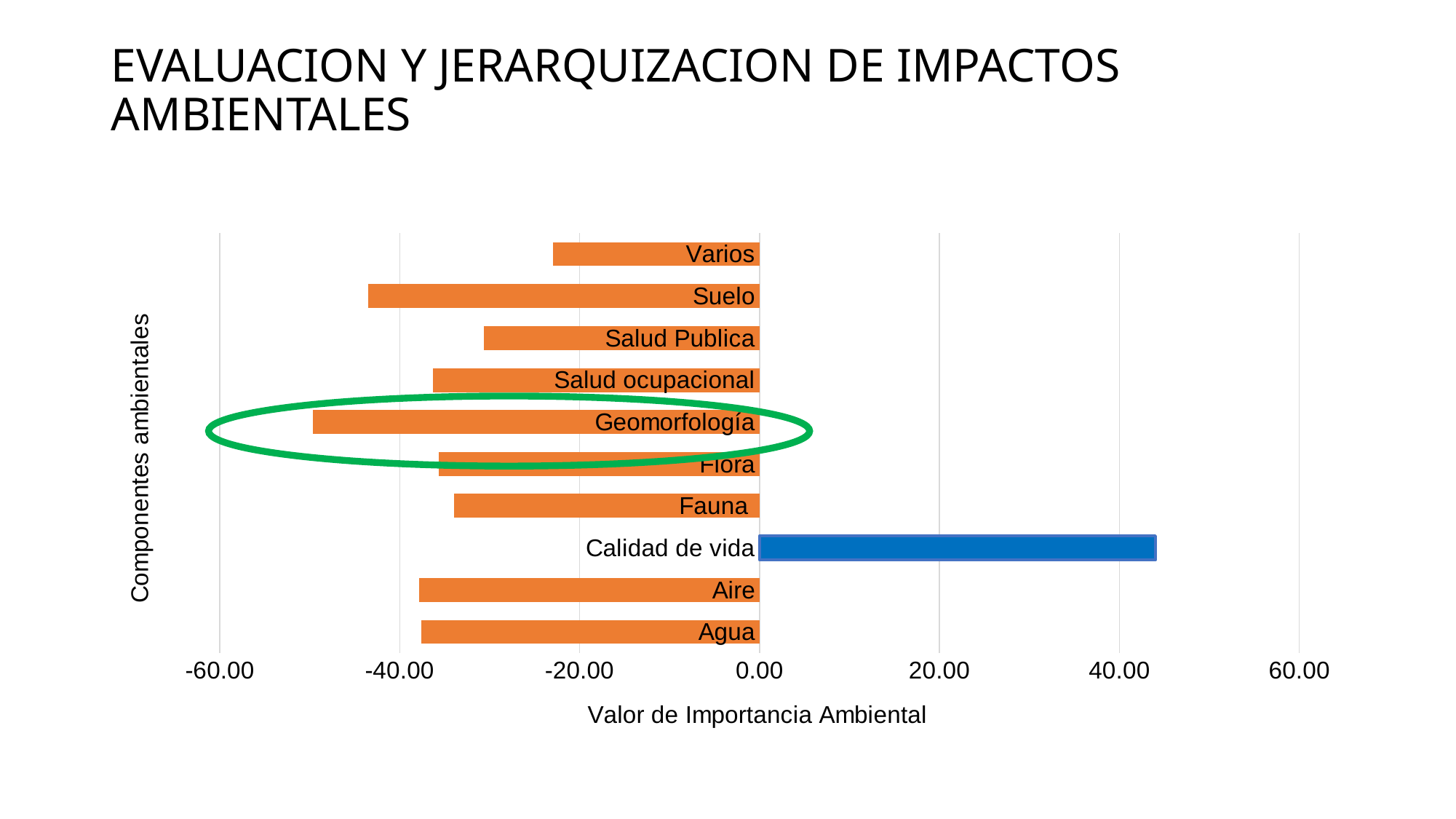
Which bar extends further from zero, Suelo or Varios? Suelo Which category has the highest value in the chart? Calidad de vida Which category has the lowest (most negative) value in the chart? Geomorfología What kind of chart is shown on the slide? bar chart Is the value for Fauna greater or less than -40.00? greater Is the value for Calidad de vida greater or less than 40.00? greater Is the value for Suelo greater or less than -40.00? less Which category is highlighted with a green ellipse on the chart? Geomorfología What is the title of the horizontal (x) axis of the chart? Valor de Importancia Ambiental How many environmental components (categories) are plotted in the chart? 10